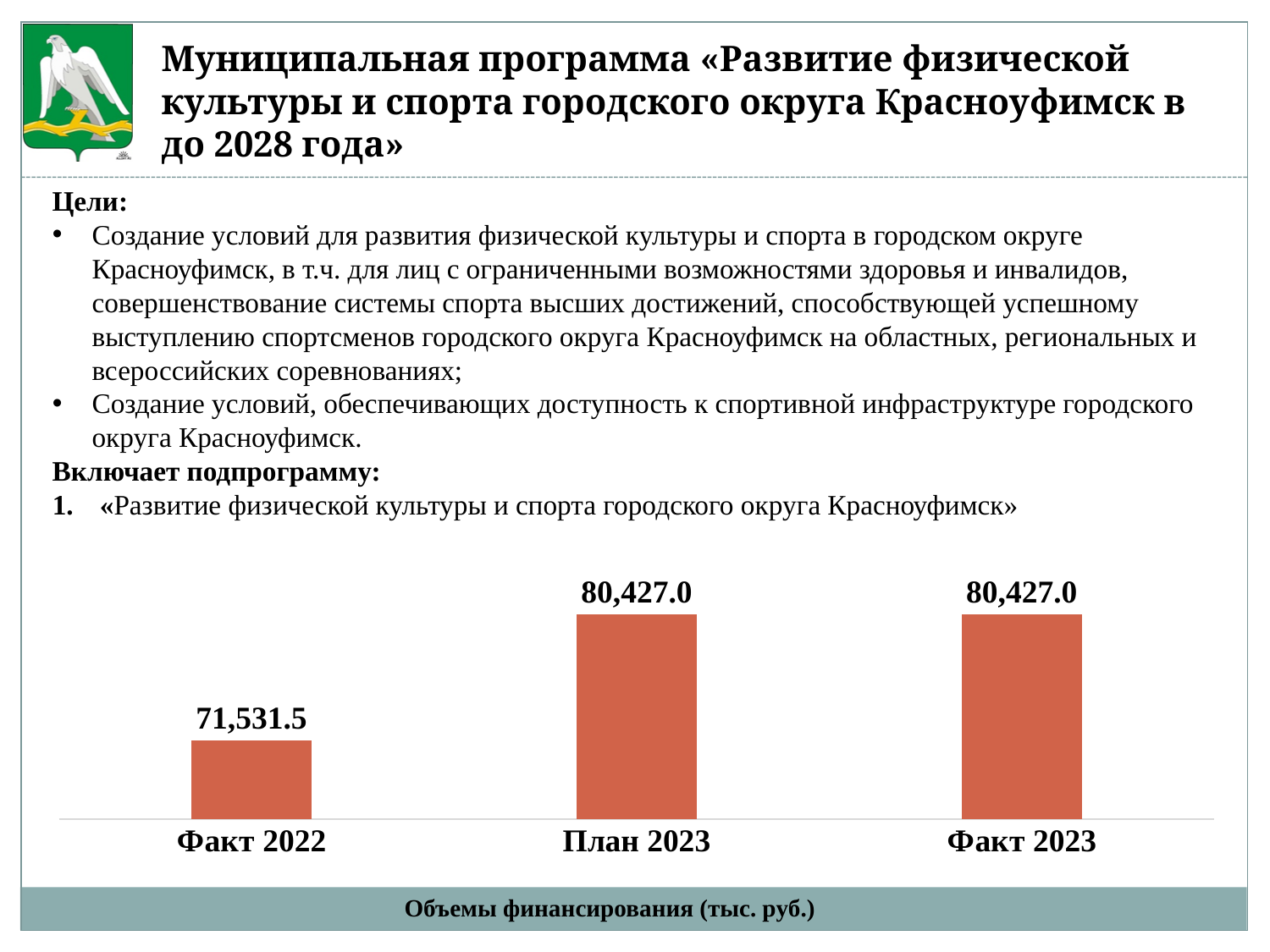
What kind of chart is shown on the slide? Bar chart What is the difference between the values for План 2023 and Факт 2022? 8,895.5 In what units are the chart values given, according to the caption? тыс. руб. What is the value for Факт 2022? 71,531.5 Is the value for План 2023 larger than, smaller than, or equal to the value for Факт 2023? Equal What is the value for План 2023? 80,427.0 What is the value for Факт 2023? 80,427.0 Does the value rise or fall from Факт 2022 to План 2023? Rise Which category has the lowest value? Факт 2022 How many categories are shown on the chart? 3 What caption is shown below the chart? Объемы финансирования (тыс. руб.) Which is larger, the value for Факт 2022 or the value for Факт 2023? Факт 2023